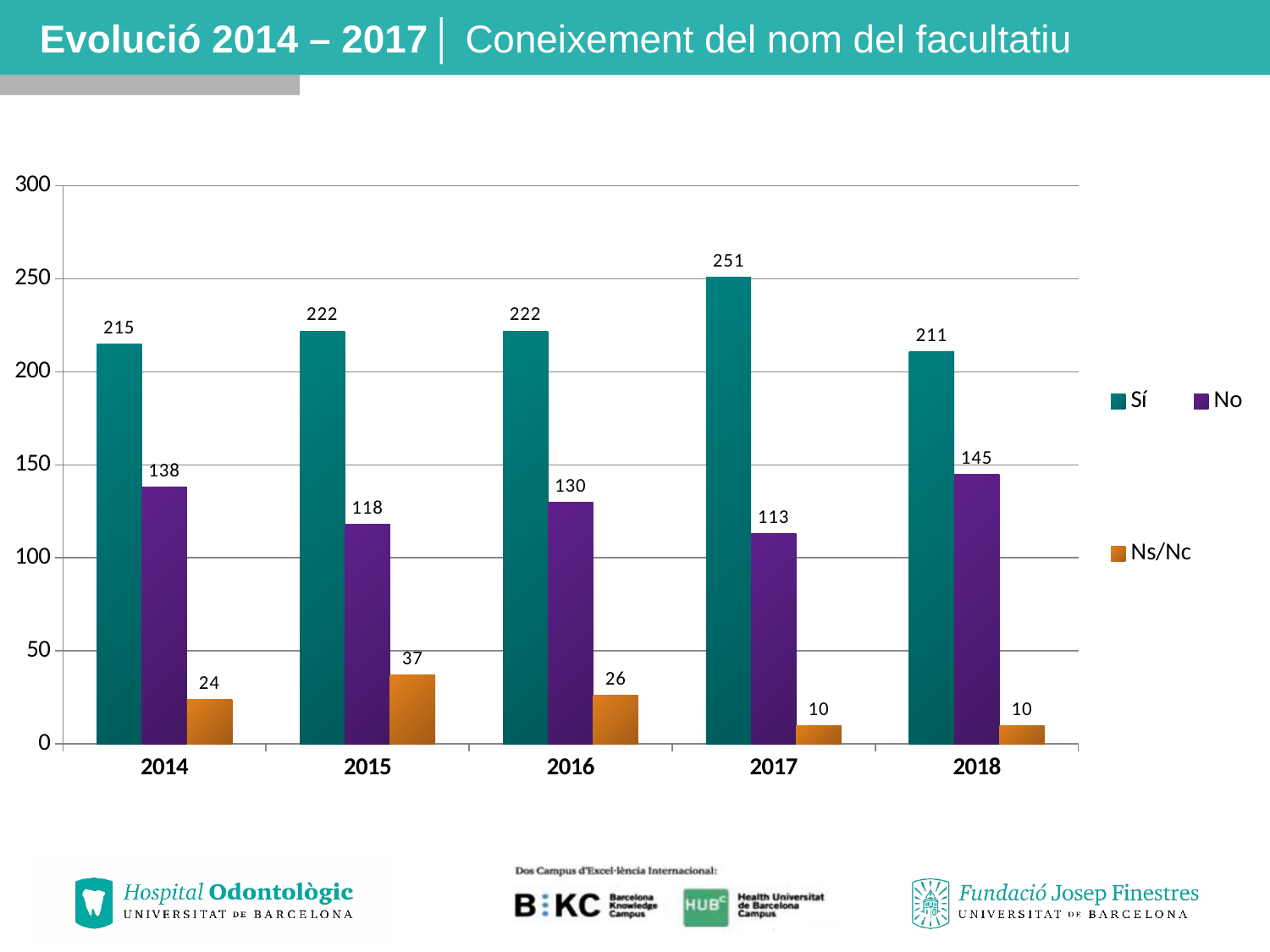
Which is larger, the No value in 2014 or the No value in 2016? 2014 What is the total of the Sí, No and Ns/Nc values for 2015? 377 What is the difference between the Sí and No values in 2018? 66 How many years are shown on the x axis? 5 What kind of chart is shown on the slide? bar chart In which year is the Sí value highest? 2017 What is the value for Ns/Nc in 2016? 26 What is the value for Sí in 2017? 251 How many series does the legend list? 3 Is the Sí value for 2018 greater or less than 200? greater In which year is the No value lowest? 2017 What is the value for No in 2015? 118